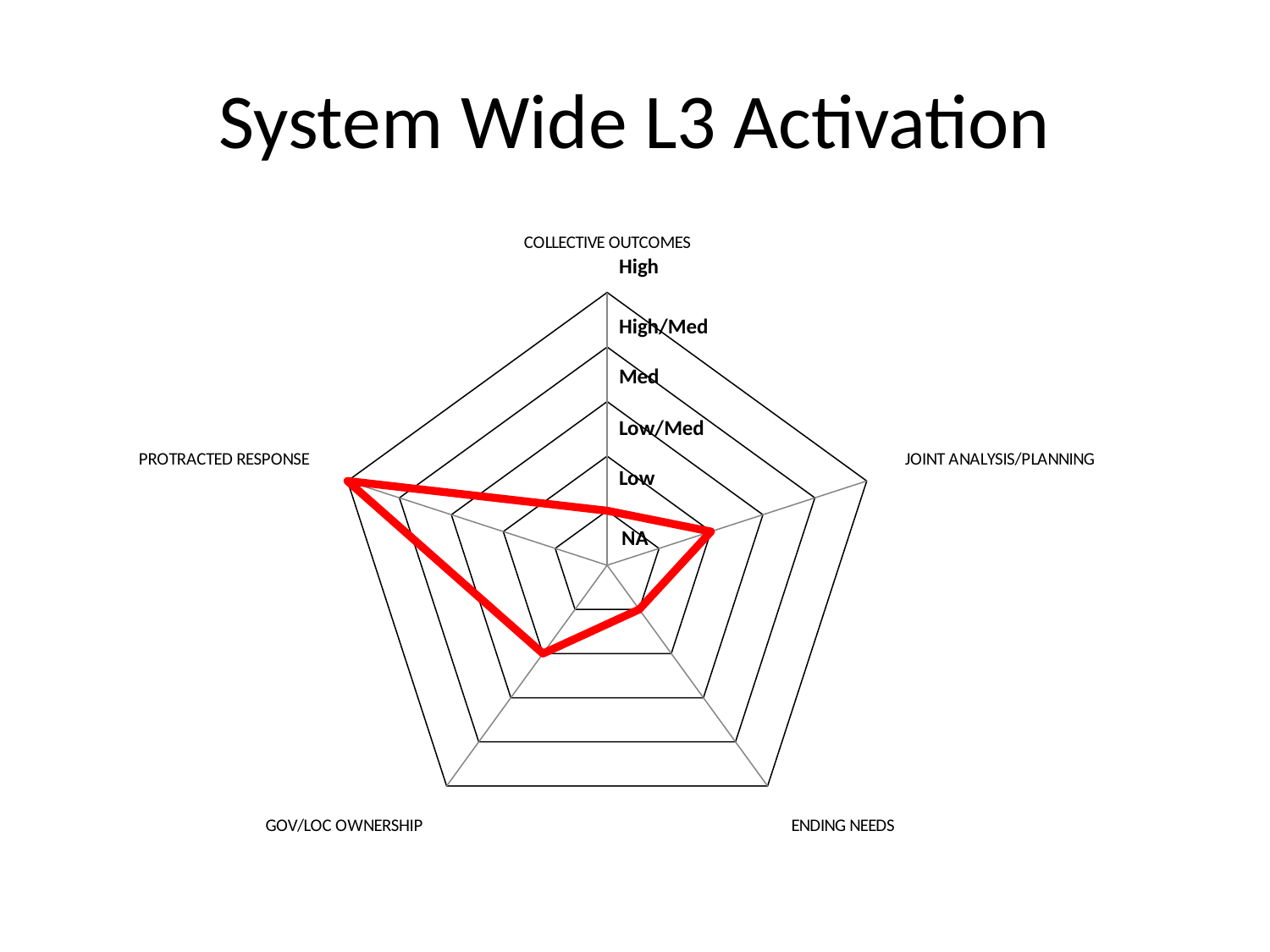
What level does the plotted line reach for COLLECTIVE OUTCOMES? Low What colour is the plotted line on the radar chart? Red How many categories (axes) does the radar chart have? 5 What level does the plotted line reach for ENDING NEEDS? Low What level does the plotted line reach for GOV/LOC OWNERSHIP? Low/Med What level does the plotted line reach for JOINT ANALYSIS/PLANNING? Low/Med What kind of chart is shown on the slide? Radar chart What is the title of the chart on the slide? System Wide L3 Activation Which category has the highest level on the radar chart? PROTRACTED RESPONSE Which is rated higher, PROTRACTED RESPONSE or COLLECTIVE OUTCOMES? PROTRACTED RESPONSE What level does the plotted line reach for PROTRACTED RESPONSE? High Which is rated higher, JOINT ANALYSIS/PLANNING or ENDING NEEDS? JOINT ANALYSIS/PLANNING